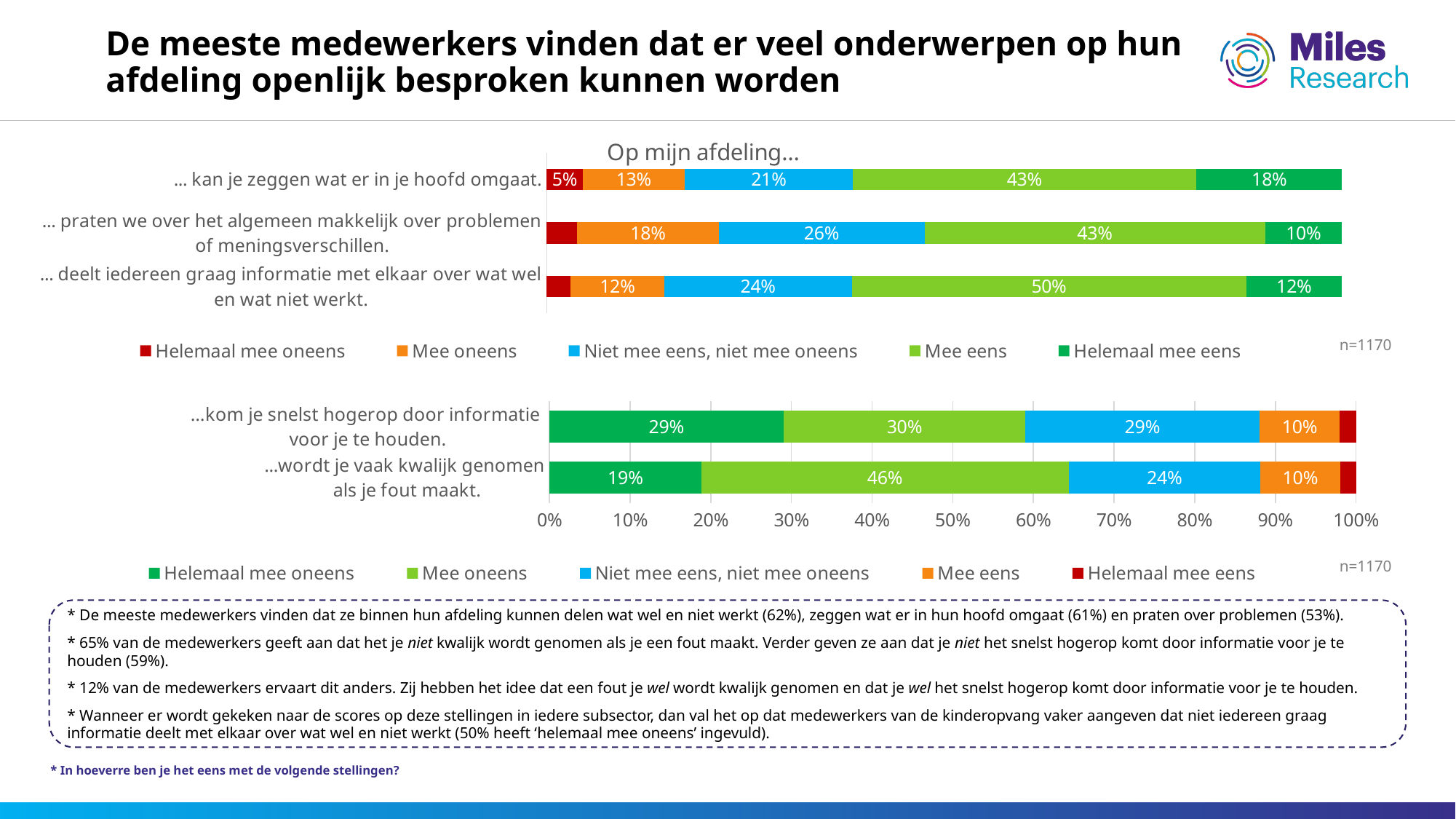
In the bottom chart, what percentage chose 'Mee oneens' for '...wordt je vaak kwalijk genomen als je fout maakt.'? 46% In the top chart 'Op mijn afdeling...', what percentage chose 'Niet mee eens, niet mee oneens' for '... praten we over het algemeen makkelijk over problemen of meningsverschillen.'? 26% How many series does the legend of the top chart 'Op mijn afdeling...' list? 5 In the top chart 'Op mijn afdeling...', what percentage chose 'Helemaal mee eens' for '... deelt iedereen graag informatie met elkaar over wat wel en wat niet werkt.'? 12% In the top chart 'Op mijn afdeling...', which statement has the highest 'Mee eens' percentage? ... deelt iedereen graag informatie met elkaar over wat wel en wat niet werkt. In the bottom chart, what percentage chose 'Helemaal mee oneens' for '...kom je snelst hogerop door informatie voor je te houden.'? 29% How many statements are shown in the bottom chart? 2 What type of chart is the top chart 'Op mijn afdeling...'? Stacked bar chart In the bottom chart, what is the difference in 'Mee oneens' percentage between '...wordt je vaak kwalijk genomen als je fout maakt.' and '...kom je snelst hogerop door informatie voor je te houden.'? 16 percentage points In the top chart 'Op mijn afdeling...', which is larger: the 'Mee oneens' share for '... praten we over het algemeen makkelijk over problemen of meningsverschillen.' or for '... deelt iedereen graag informatie met elkaar over wat wel en wat niet werkt.'? ... praten we over het algemeen makkelijk over problemen of meningsverschillen. In the top chart 'Op mijn afdeling...', what percentage chose 'Mee eens' for '... kan je zeggen wat er in je hoofd omgaat.'? 43% In the top chart 'Op mijn afdeling...', which statement has the highest 'Helemaal mee eens' percentage? ... kan je zeggen wat er in je hoofd omgaat.